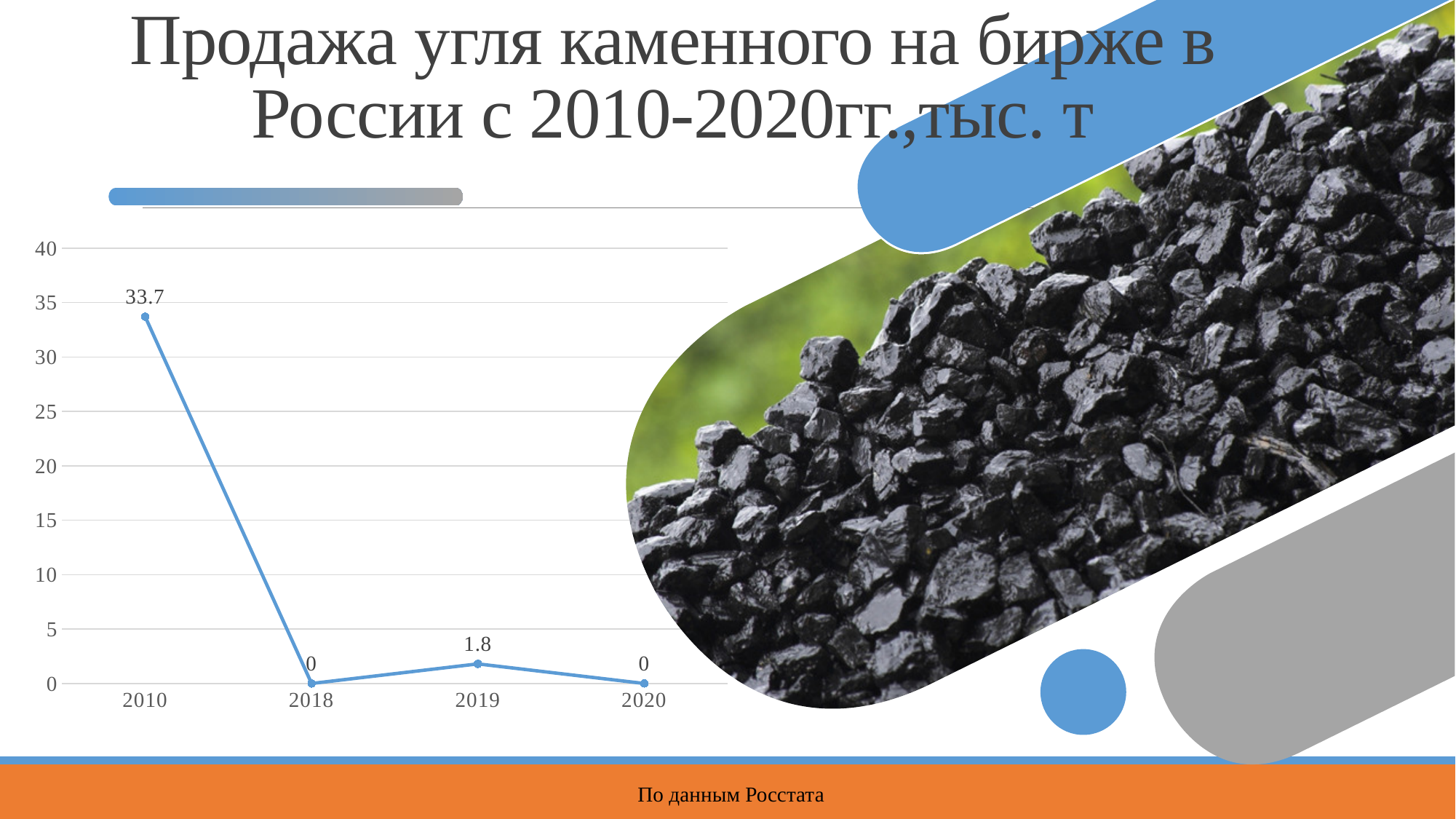
Which is larger, the value for 2019 or the value for 2020? 2019 What is the difference between the values for 2010 and 2019? 31.9 What is the value for 2010? 33.7 Do the values rise or fall from 2010 to 2018? fall Which year has the highest value? 2010 What is the value for 2020? 0 How many years are plotted on the chart? 4 What kind of chart is shown on the slide? line chart What is the title of the slide? Продажа угля каменного на бирже в России с 2010-2020гг.,тыс. т What is the value for 2019? 1.8 What is the value for 2018? 0 Is the value for 2010 greater or less than 30? greater